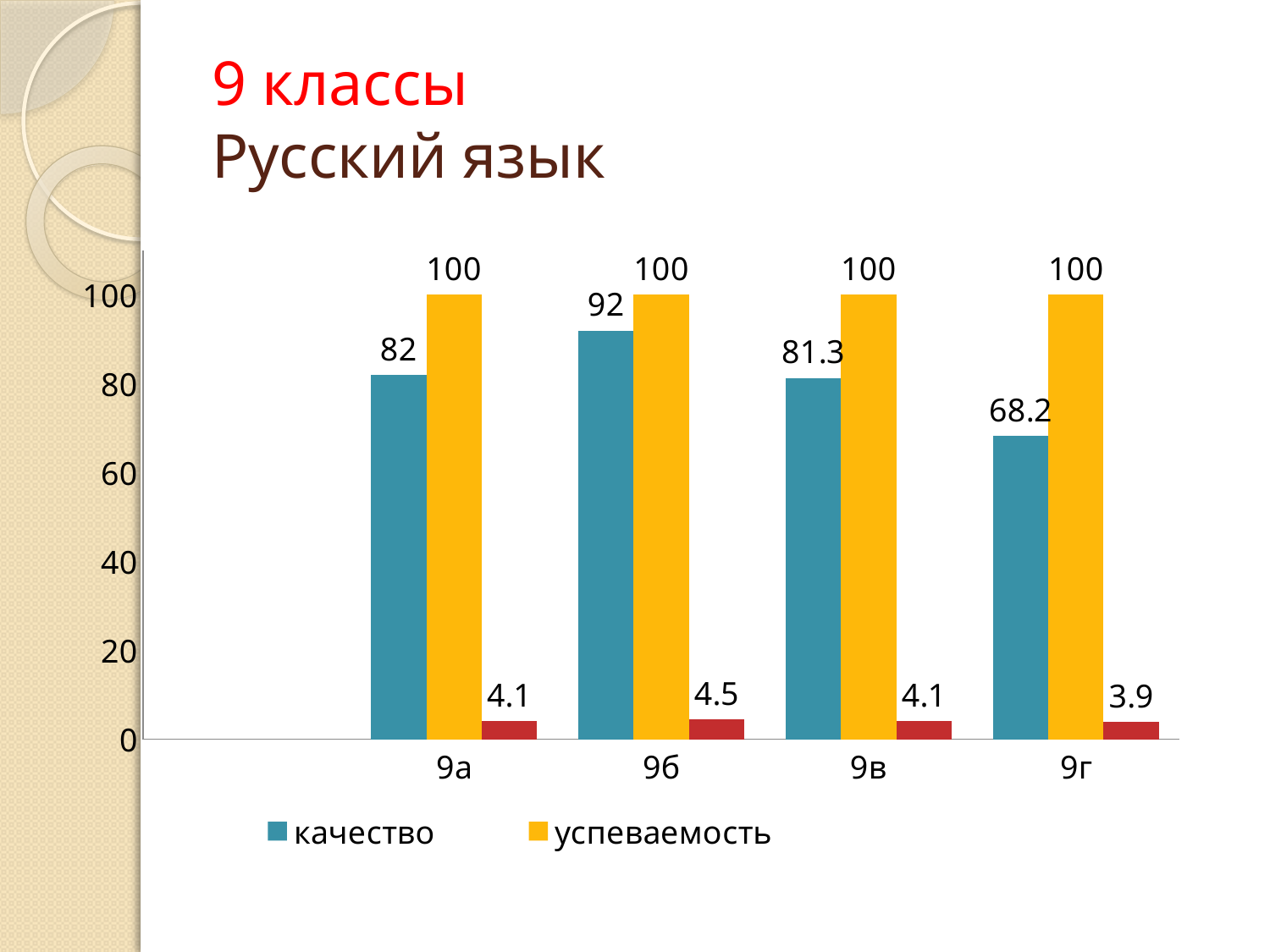
Which class has the highest качество value? 9б Which class has the lowest качество value? 9г What is the успеваемость value for 9в? 100 How many series does the legend list? 2 What is the value of the red bar for 9б? 4.5 What kind of chart is shown on the slide? bar chart What is the difference between the качество values for 9а and 9г? 13.8 How many classes are shown on the x axis? 4 What colour are the успеваемость bars? yellow What is the качество value for 9г? 68.2 What is the качество value for 9б? 92 Which is larger, the качество value for 9а or for 9в? 9а